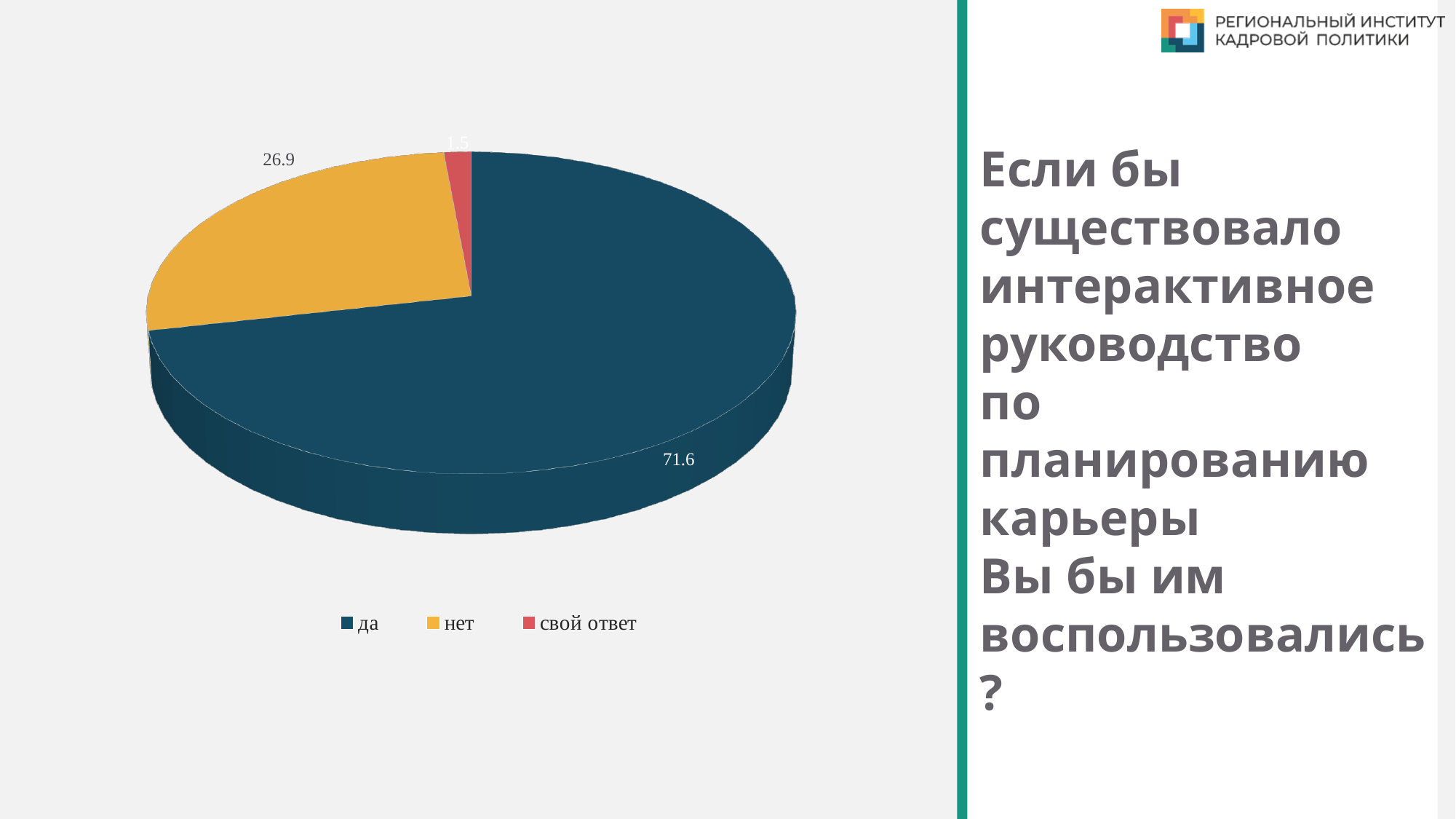
How many slices does the pie chart have? 3 What is the value for "нет"? 26.9 How many entries does the legend list? 3 What colour is the slice for "нет"? yellow Which is larger, the value for "нет" or the value for "свой ответ"? нет Which category has the largest slice? да What is the difference between the values for "да" and "нет"? 44.7 What is the value for "свой ответ"? 1.5 What kind of chart is shown on the slide? pie chart What is the value for "да"? 71.6 Which category has the smallest slice? свой ответ What is the difference between the values for "нет" and "свой ответ"? 25.4